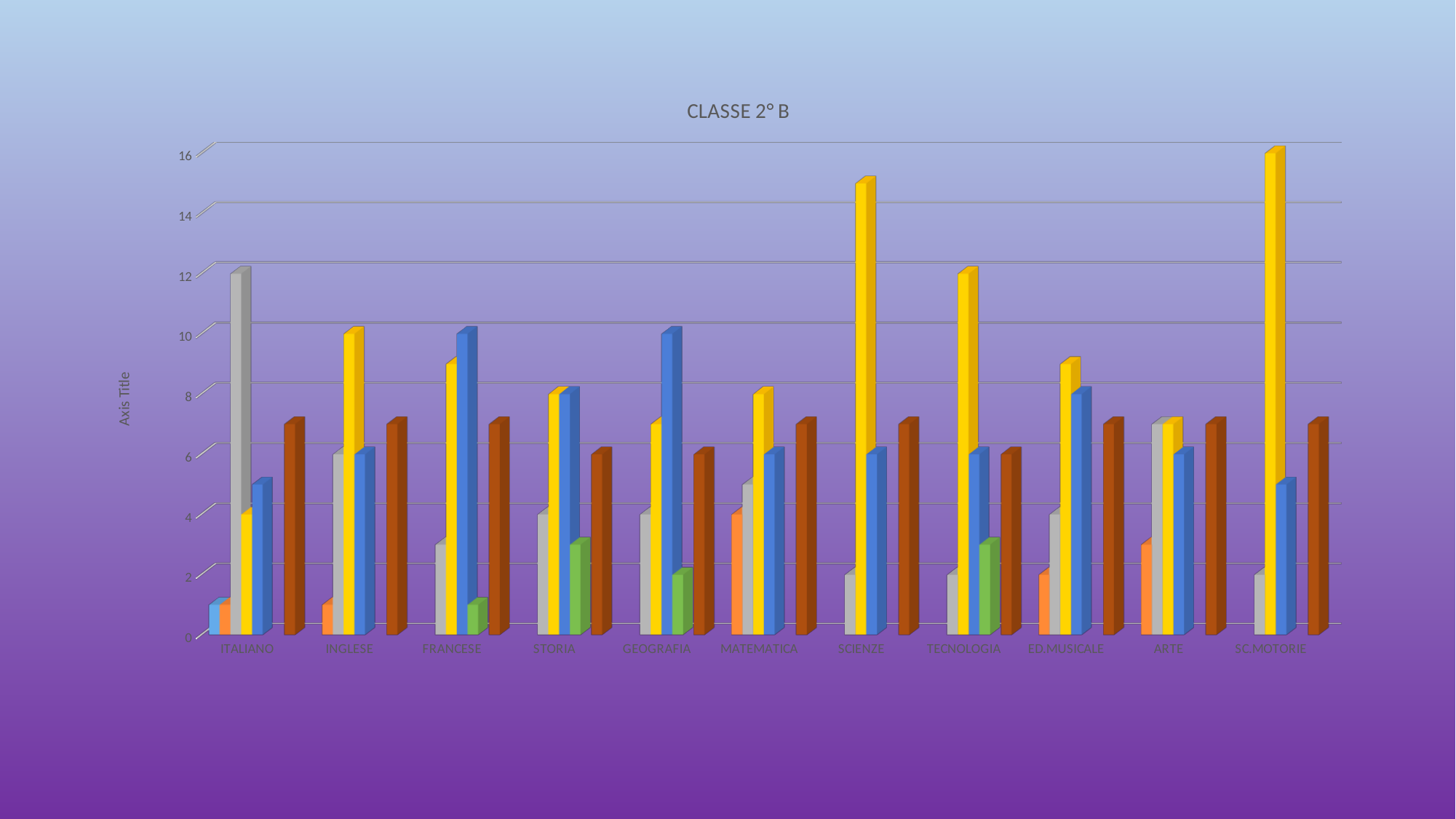
Which category has the taller tallest bar, SCIENZE or TECNOLOGIA? SCIENZE Which category has the taller tallest bar, INGLESE or ARTE? INGLESE What is the title of the chart? CLASSE 2° B Is the tallest bar for MATEMATICA greater or less than 10? less Is the tallest bar for STORIA greater or less than 10? less Is the tallest bar for TECNOLOGIA greater or less than 10? greater Which category contains the tallest bar in the chart? SC.MOTORIE How many categories are shown along the x axis of the chart? 11 What kind of chart is shown on the slide? bar chart What is the label on the vertical axis of the chart? Axis Title